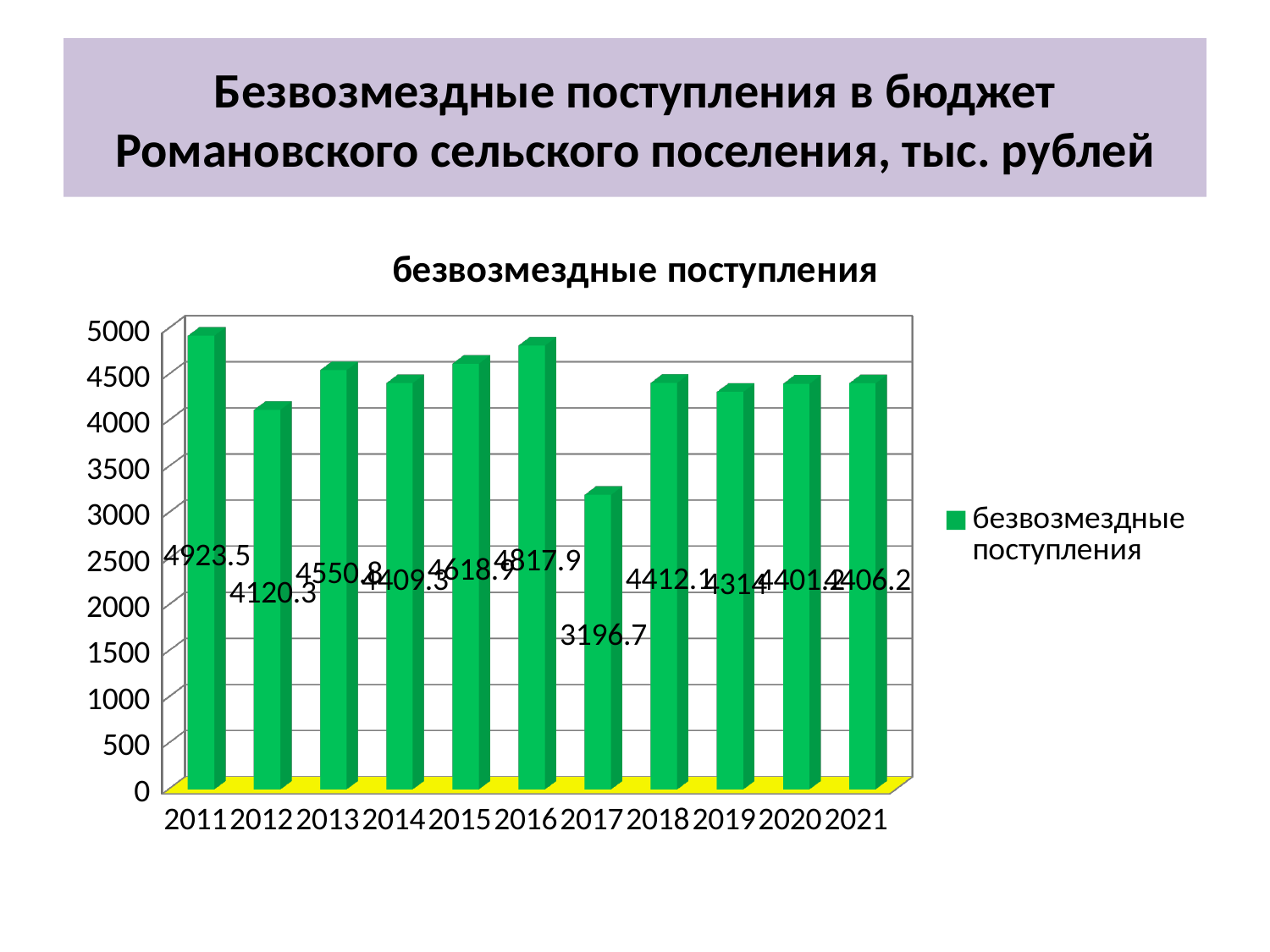
What is the difference between the values for 2011 and 2017? 1726.8 Which year has the lowest value? 2017 What is the value for 2017? 3196.7 What is the legend entry for the series? безвозмездные поступления What is the value for 2011? 4923.5 How many years are shown on the x axis? 11 How many series does the legend list? 1 What kind of chart is shown? bar chart Is the value for 2012 greater or less than 4500? less What is the value for 2016? 4817.9 Which is larger, the value for 2013 or the value for 2014? 2013 Which year has the highest value? 2011